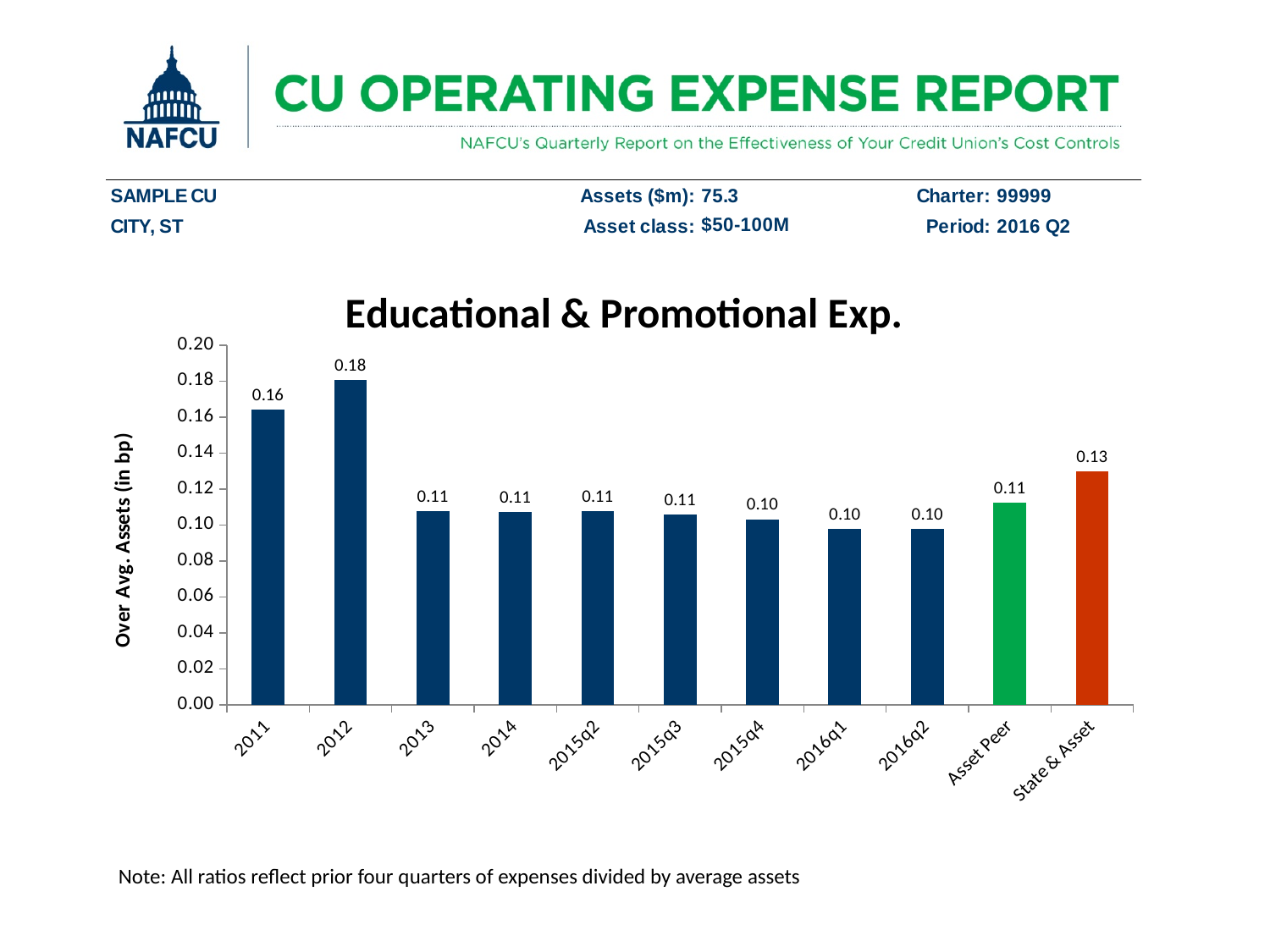
How many categories are shown on the x axis of the Educational & Promotional Exp. chart? 11 What is the difference between the State & Asset value and the Asset Peer value in the Educational & Promotional Exp. chart? 0.02 What kind of chart is the Educational & Promotional Exp. chart? bar chart Which is larger in the Educational & Promotional Exp. chart, the value for 2011 or the value for 2013? 2011 Which category has the highest value in the Educational & Promotional Exp. chart? 2012 What is the value for State & Asset in the Educational & Promotional Exp. chart? 0.13 Do the values in the Educational & Promotional Exp. chart generally rise or fall from 2011 to 2016q2? fall What is the difference between the 2012 value and the 2011 value in the Educational & Promotional Exp. chart? 0.02 What is the y-axis title of the Educational & Promotional Exp. chart? Over Avg. Assets (in bp) Is the value for 2013 in the Educational & Promotional Exp. chart greater or less than 0.14? less What is the value for Asset Peer in the Educational & Promotional Exp. chart? 0.11 What is the value for 2012 in the Educational & Promotional Exp. chart? 0.18